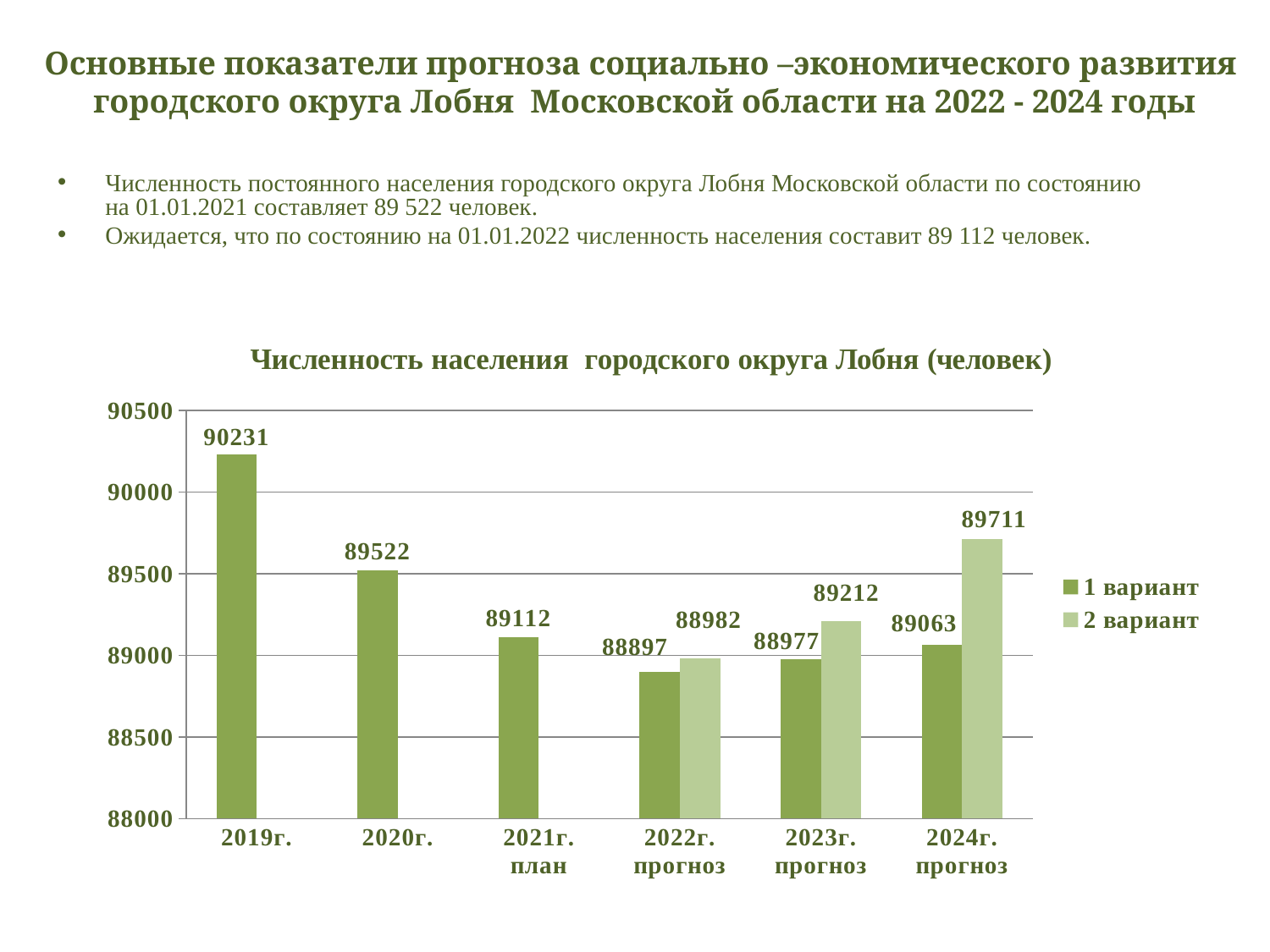
Which category has the highest value for 1 вариант? 2019г. Do the 2 вариант values rise or fall from 2022г. прогноз to 2024г. прогноз? rise How many series does the legend list? 2 Which category has the lowest value for 1 вариант? 2022г. прогноз What is the value for 2 вариант in 2024г. прогноз? 89711 What kind of chart is shown on the slide? bar chart What is the difference between the 2 вариант and 1 вариант values in 2023г. прогноз? 235 Is the value for 1 вариант in 2020г. greater or less than 89500? greater What is the value for 1 вариант in 2019г.? 90231 What is the value for 1 вариант in 2022г. прогноз? 88897 How many categories are shown on the x axis? 6 Which is larger in 2024г. прогноз: 1 вариант or 2 вариант? 2 вариант